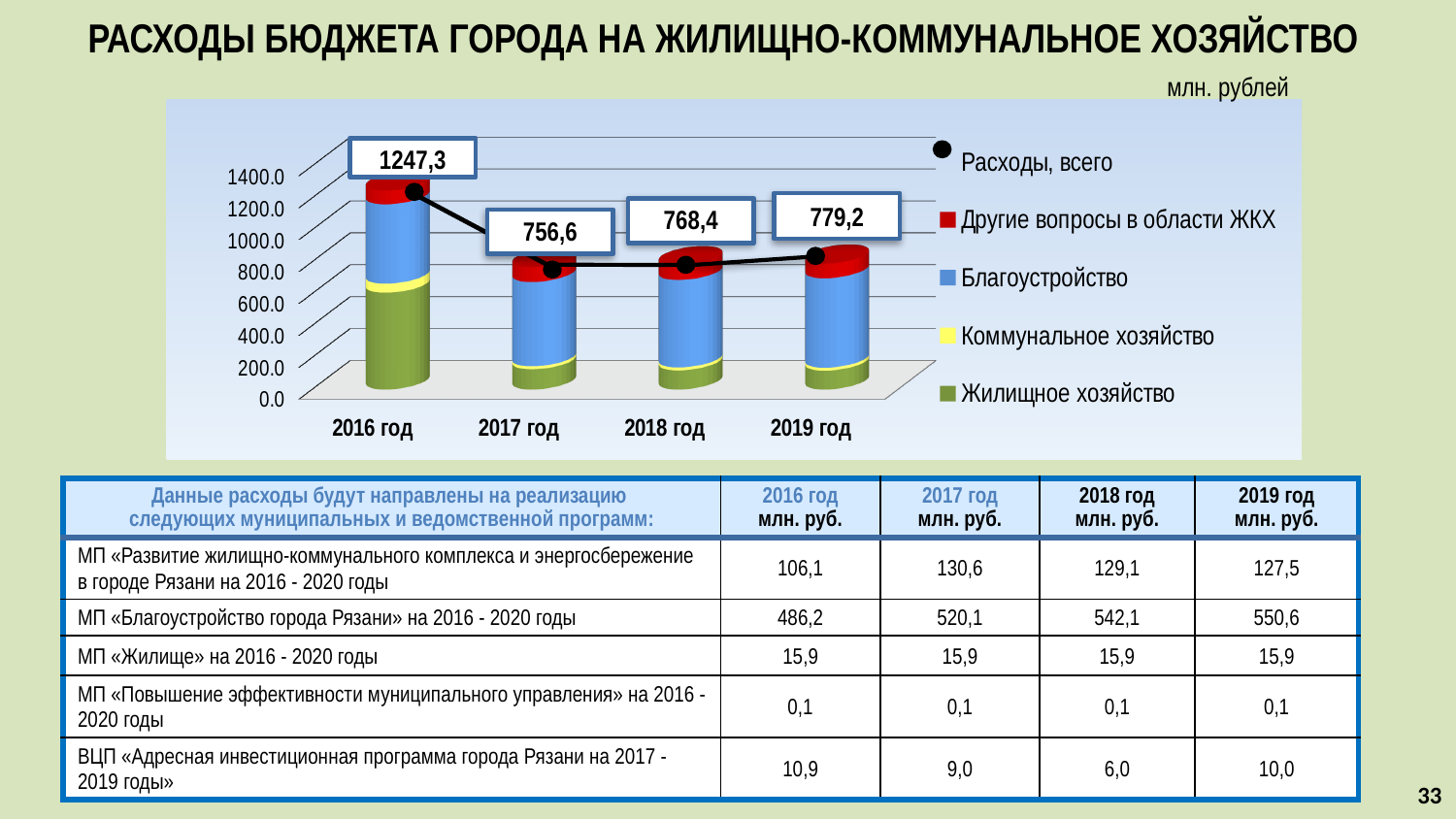
How many series does the chart legend list? 5 In which year is «Расходы, всего» the lowest? 2017 год Which is larger, «Расходы, всего» in 2019 год or in 2018 год? 2019 год What is the value of «Расходы, всего» for 2019 год? 779,2 How many years (categories) are shown on the x axis of the chart? 4 In which year is «Расходы, всего» the highest? 2016 год What is the value of «Расходы, всего» for 2018 год? 768,4 What is the value of «Расходы, всего» for 2016 год? 1247,3 What kind of chart is shown on the slide? Stacked bar chart with a line What is the difference between «Расходы, всего» in 2016 год and 2017 год? 490,7 What is the value of «Расходы, всего» for 2017 год? 756,6 Does «Расходы, всего» rise or fall from 2017 год to 2019 год? Rise